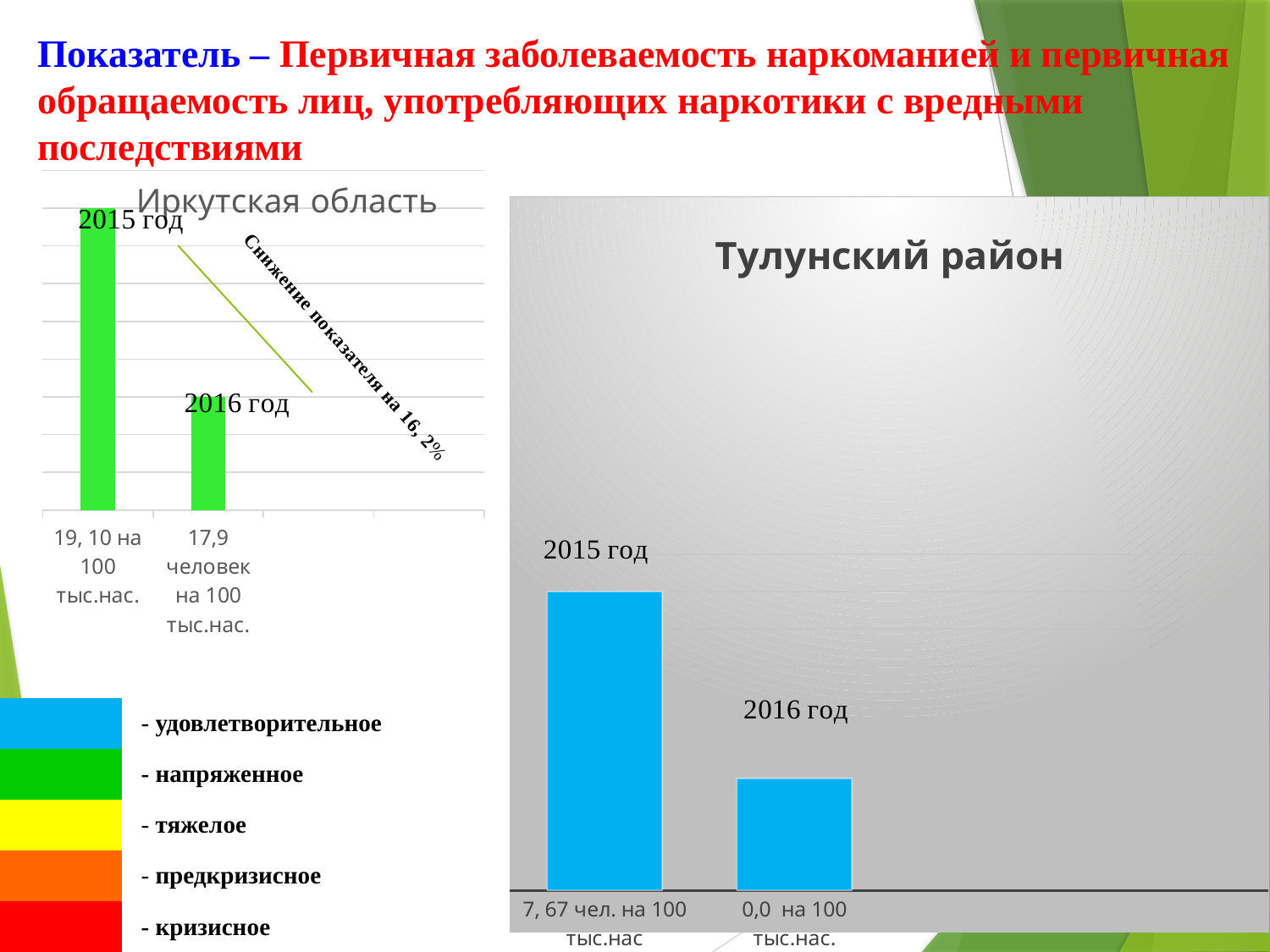
In the Иркутская область chart, what value is printed for 2015 год? 19, 10 на 100 тыс.нас. In the Тулунский район chart, is the bar for 2015 год taller or shorter than the bar for 2016 год? taller In the Тулунский район chart, what value is printed for 2015 год? 7, 67 чел. на 100 тыс.нас In the Иркутская область chart, what value is printed for 2016 год? 17,9 человек на 100 тыс.нас. How many bars are shown in the Иркутская область chart? 2 How many bars are shown in the Тулунский район chart? 2 In the Иркутская область chart, which year has the taller bar? 2015 год Do the values in the Иркутская область chart rise or fall from 2015 год to 2016 год? fall According to the annotation on the Иркутская область chart, by what percentage did the indicator decrease? 16, 2% In the Тулунский район chart, which year has the shorter bar? 2016 год What kind of chart is the Тулунский район chart? bar chart What kind of chart is the Иркутская область chart? bar chart